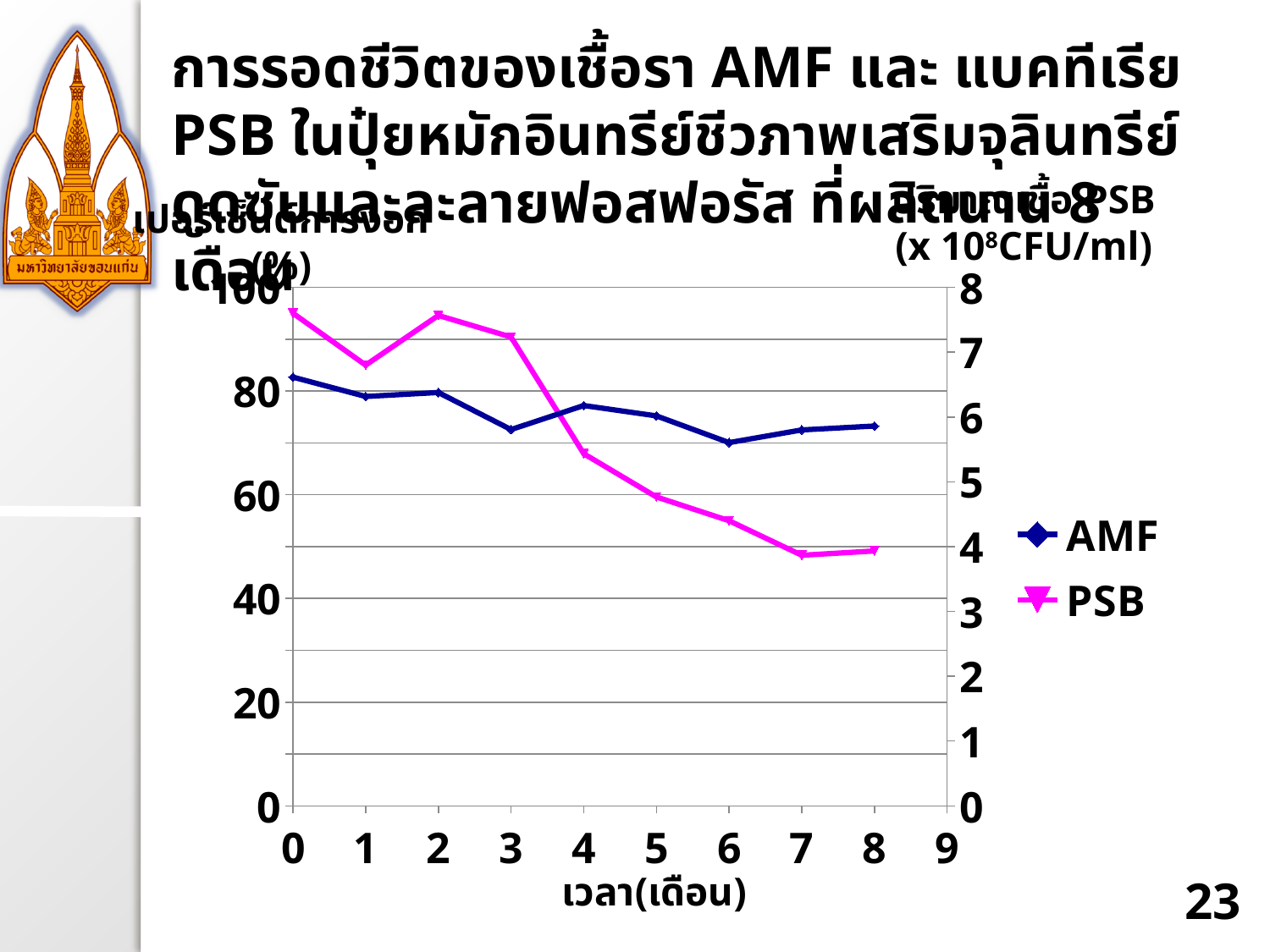
Is the PSB value at month 0 greater or less than 7 on the right axis? greater How many data points are plotted for the PSB series? 9 Does the PSB series generally rise or fall from month 0 to month 8? fall Is the AMF value at month 6 greater or less than 80? less Is the PSB value at month 8 greater or less than 5 on the right axis? less At which month is the AMF series at its lowest? 6 What kind of chart is shown on the slide? line chart Which two series are listed in the legend? AMF and PSB Which is larger for the PSB series: the value at month 4 or the value at month 6? month 4 How many series does the legend list? 2 What is the title of the x axis? เวลา(เดือน)